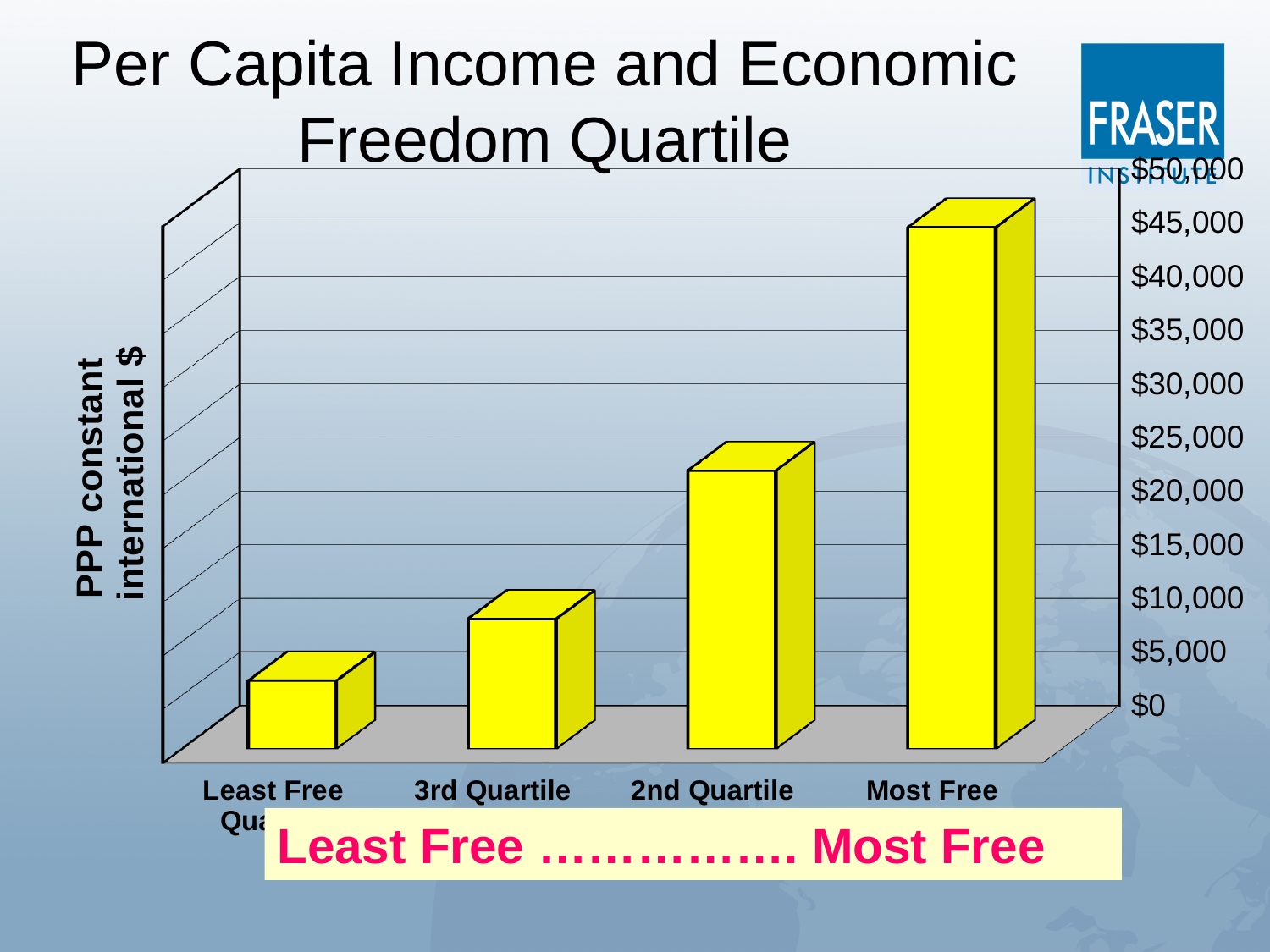
Is the value for the 2nd Quartile greater or less than $15,000? greater Is the value for the 3rd Quartile greater or less than $15,000? less What is the label on the vertical axis of the chart? PPP constant international $ What kind of chart is shown on the slide? bar chart Which category has the highest per capita income? Most Free Which category has the lowest per capita income? Least Free Quartile Is the value for Most Free greater or less than $40,000? greater What is the title of the chart? Per Capita Income and Economic Freedom Quartile How many quartile categories are plotted on the chart? 4 Do the bar values rise or fall moving from Least Free to Most Free along the x axis? rise Which has a higher per capita income, the 2nd Quartile or the 3rd Quartile? 2nd Quartile